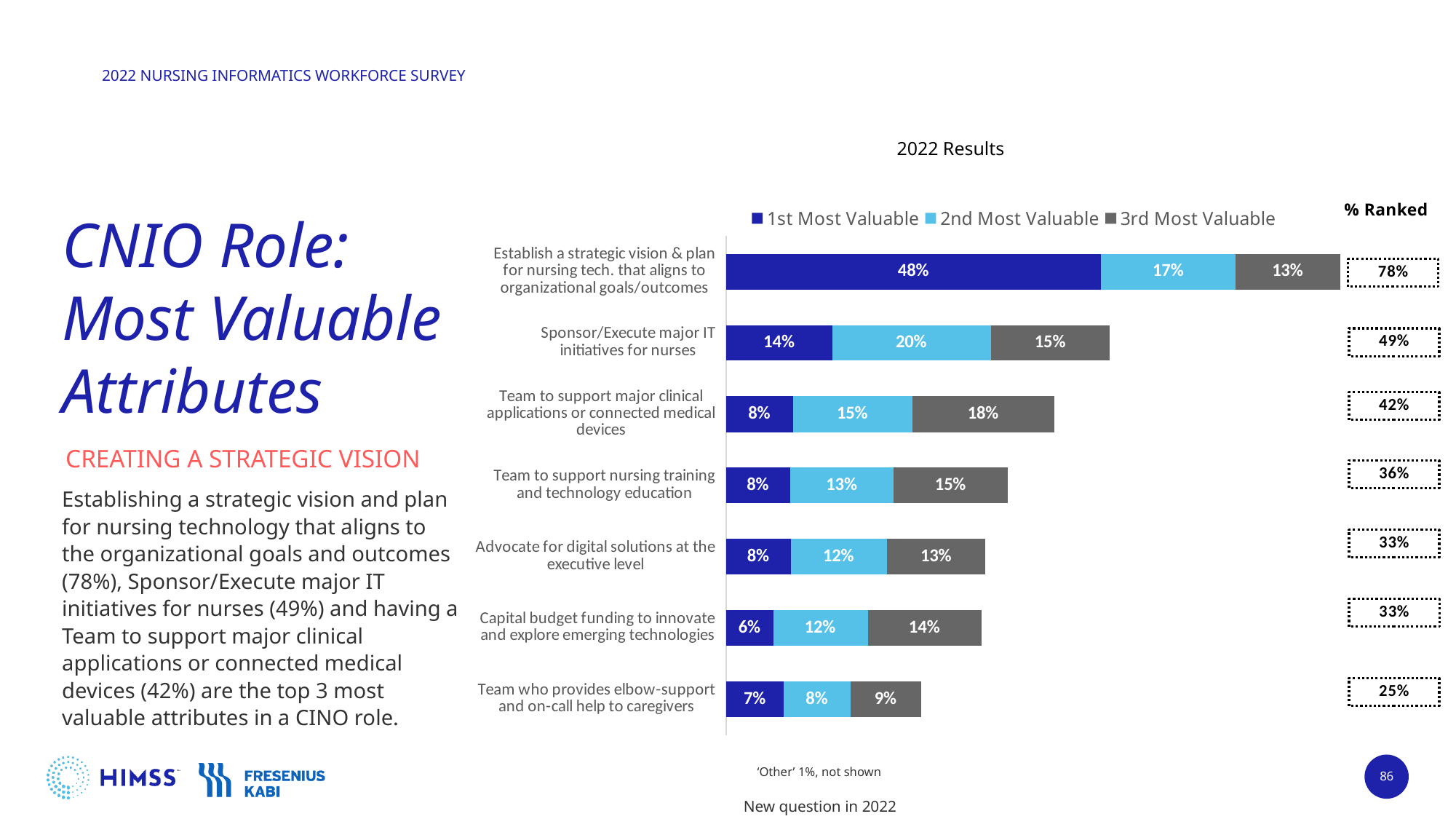
What kind of chart is shown on the slide? Stacked bar chart What is the total % Ranked for 'Advocate for digital solutions at the executive level'? 33% What is the title shown above the chart? 2022 Results How many series does the legend list? 3 Which attribute has the lowest total % Ranked? Team who provides elbow-support and on-call help to caregivers What is the difference between the 1st Most Valuable values for 'Establish a strategic vision & plan' and 'Sponsor/Execute major IT initiatives for nurses'? 34% What is the 3rd Most Valuable value for 'Team to support major clinical applications or connected medical devices'? 18% Which is larger: the 2nd Most Valuable value for 'Team to support nursing training and technology education' or for 'Capital budget funding to innovate and explore emerging technologies'? Team to support nursing training and technology education Which attribute has the highest 1st Most Valuable percentage? Establish a strategic vision & plan for nursing tech. that aligns to organizational goals/outcomes What is the 2nd Most Valuable value for 'Sponsor/Execute major IT initiatives for nurses'? 20% How many attributes (categories) are shown in the chart? 7 What percentage ranked 'Establish a strategic vision & plan for nursing tech. that aligns to organizational goals/outcomes' as 1st Most Valuable? 48%